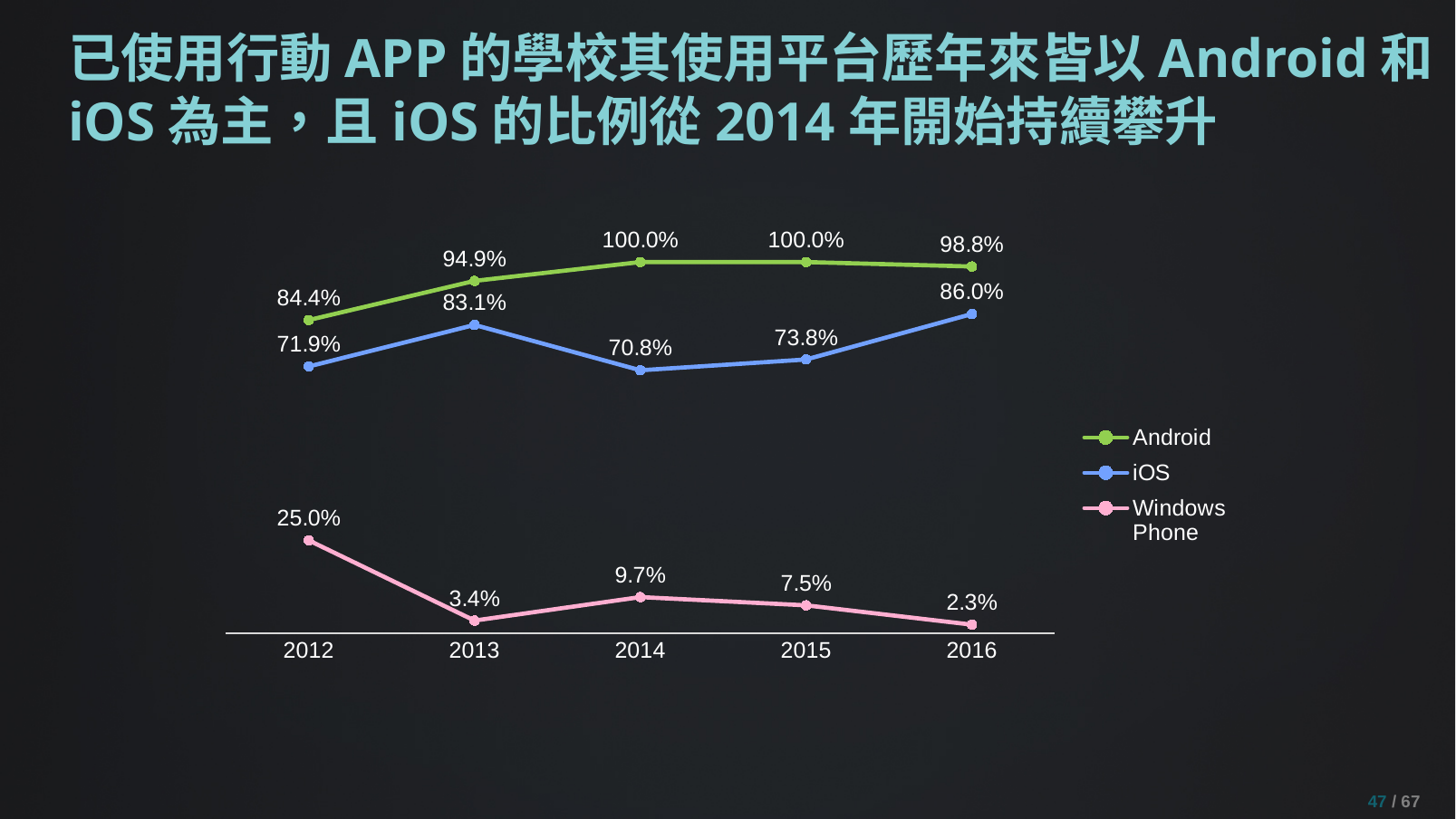
What is the value for Windows Phone in 2012? 25.0% Which series is drawn in green? Android What is the value for Android in 2013? 94.9% In which year is the Windows Phone value lowest? 2016 In which year is the iOS value highest? 2016 What is the value for iOS in 2016? 86.0% What is the difference between the Android and iOS values in 2014? 29.2% How many series does the legend list? 3 Which is larger in 2015, the iOS value or the Windows Phone value? iOS What kind of chart is shown on the slide? Line chart Does the iOS value rise or fall from 2014 to 2016? Rise How many years are shown on the x axis? 5